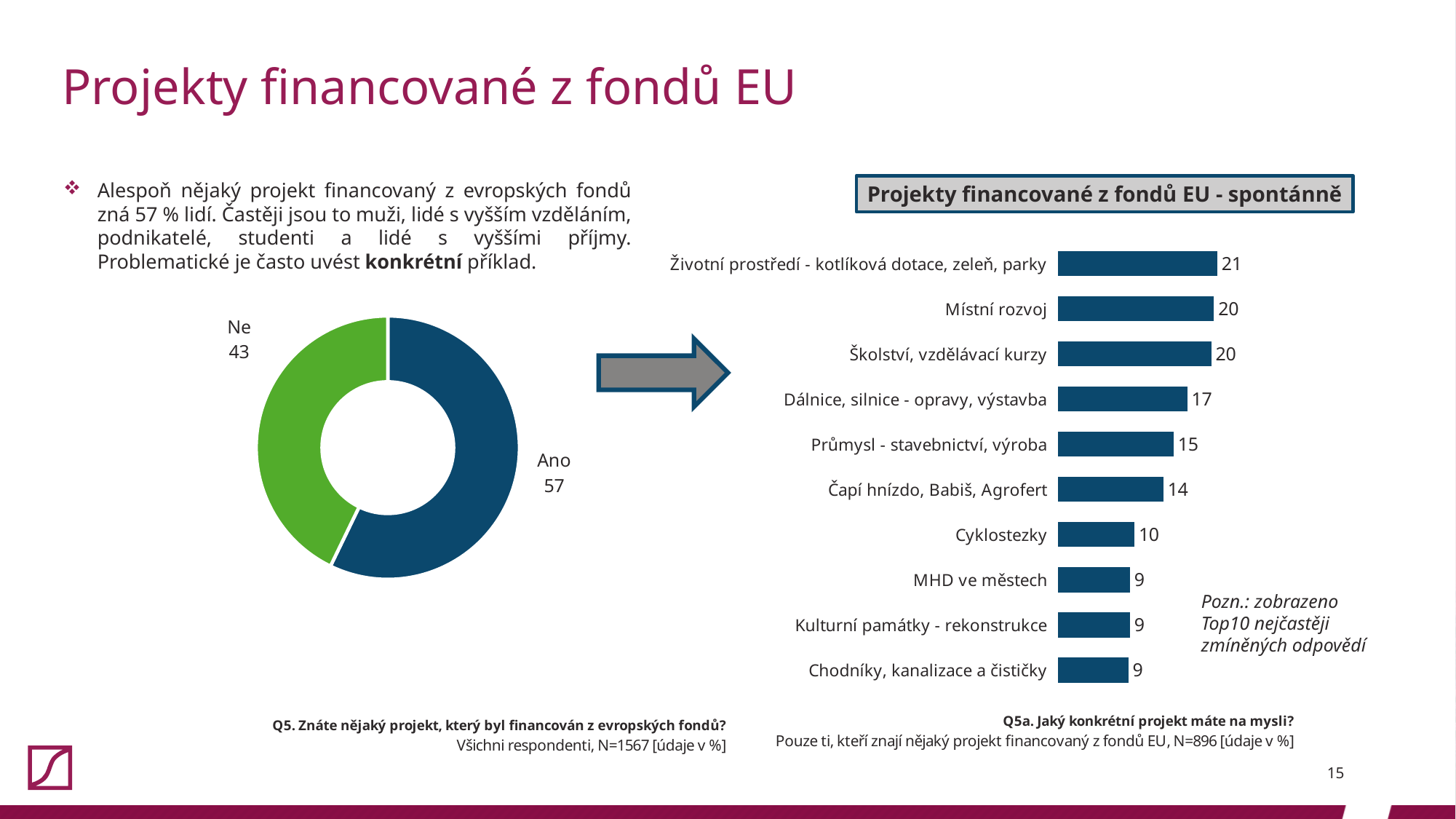
In the chart "Projekty financované z fondů EU - spontánně", what is the difference between "Místní rozvoj" and "Čapí hnízdo, Babiš, Agrofert"? 6 In the chart "Projekty financované z fondů EU - spontánně", which is larger, "Průmysl - stavebnictví, výroba" or "MHD ve městech"? Průmysl - stavebnictví, výroba In the donut chart on the left, what is the value for "Ano"? 57 In the donut chart on the left, what is the difference between the "Ano" and "Ne" values? 14 What kind of chart is "Projekty financované z fondů EU - spontánně"? Bar chart What kind of chart is the chart on the left of the slide? Donut (pie) chart In the chart "Projekty financované z fondů EU - spontánně", what is the value for "Dálnice, silnice - opravy, výstavba"? 17 In the chart "Projekty financované z fondů EU - spontánně", which category has the highest value? Životní prostředí - kotlíková dotace, zeleň, parky In the chart "Projekty financované z fondů EU - spontánně", what is the value for "Cyklostezky"? 10 In the donut chart on the left, what is the value for "Ne"? 43 In the donut chart on the left, which segment is larger, "Ano" or "Ne"? Ano In the chart "Projekty financované z fondů EU - spontánně", how many categories are shown? 10